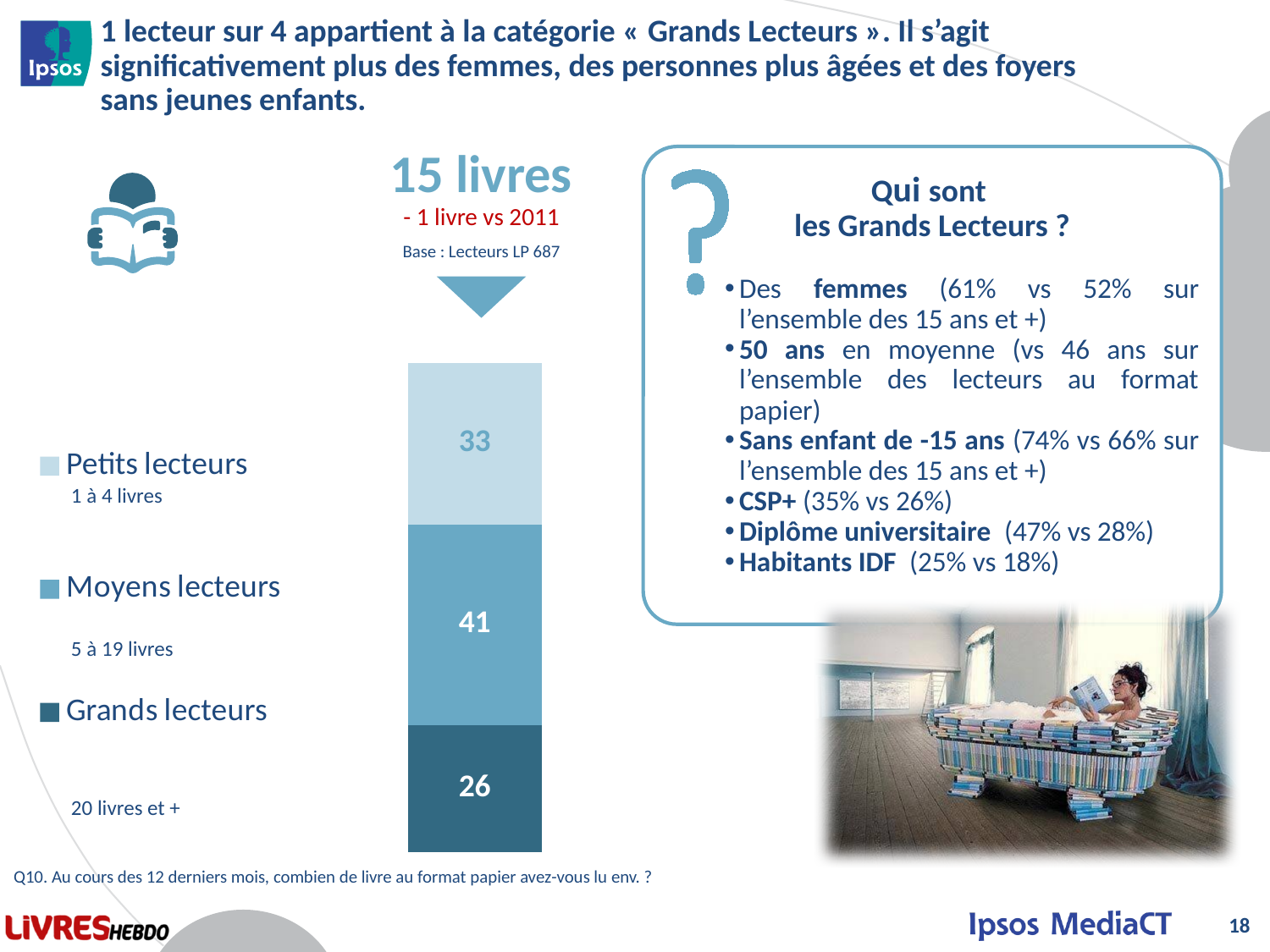
What value is shown for Petits lecteurs in the stacked bar? 33 What value is shown for Grands lecteurs in the stacked bar? 26 Which reader category has the largest segment in the stacked bar? Moyens lecteurs According to the legend, how many books define the Grands lecteurs category? 20 livres et + Which is larger, the value for Petits lecteurs or the value for Moyens lecteurs? Moyens lecteurs What value is shown for Moyens lecteurs in the stacked bar? 41 How many series does the legend list? 3 What kind of chart is shown on the slide? Stacked bar chart What is the difference between the Moyens lecteurs and Grands lecteurs values? 15 Which reader category has the smallest segment in the stacked bar? Grands lecteurs What is the total of all segments in the stacked bar? 100 What is the difference between the Petits lecteurs and Grands lecteurs values? 7